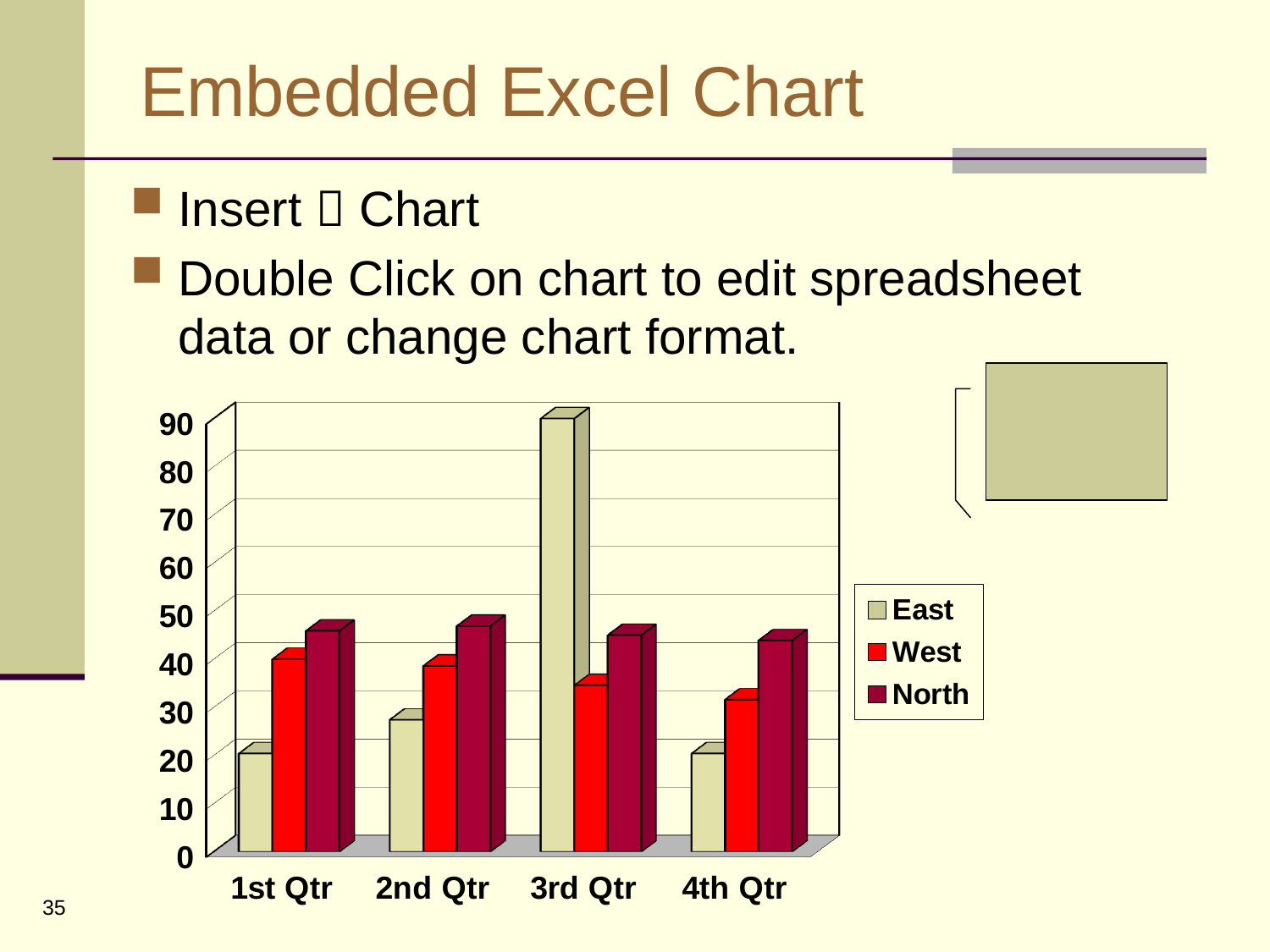
How many quarters are shown on the x axis of the chart? 4 In which quarter is the West value lowest? 4th Qtr In which quarter is the East value highest? 3rd Qtr Which series has the tallest bar in the chart? East Is the East value for 1st Qtr greater or less than 30? less What kind of chart is shown on the slide? bar chart In 3rd Qtr, which is larger: East or West? East Is the East value for 3rd Qtr greater or less than 80? greater Is the West value for 1st Qtr greater or less than 30? greater In 2nd Qtr, which is larger: East or North? North How many series does the chart legend list? 3